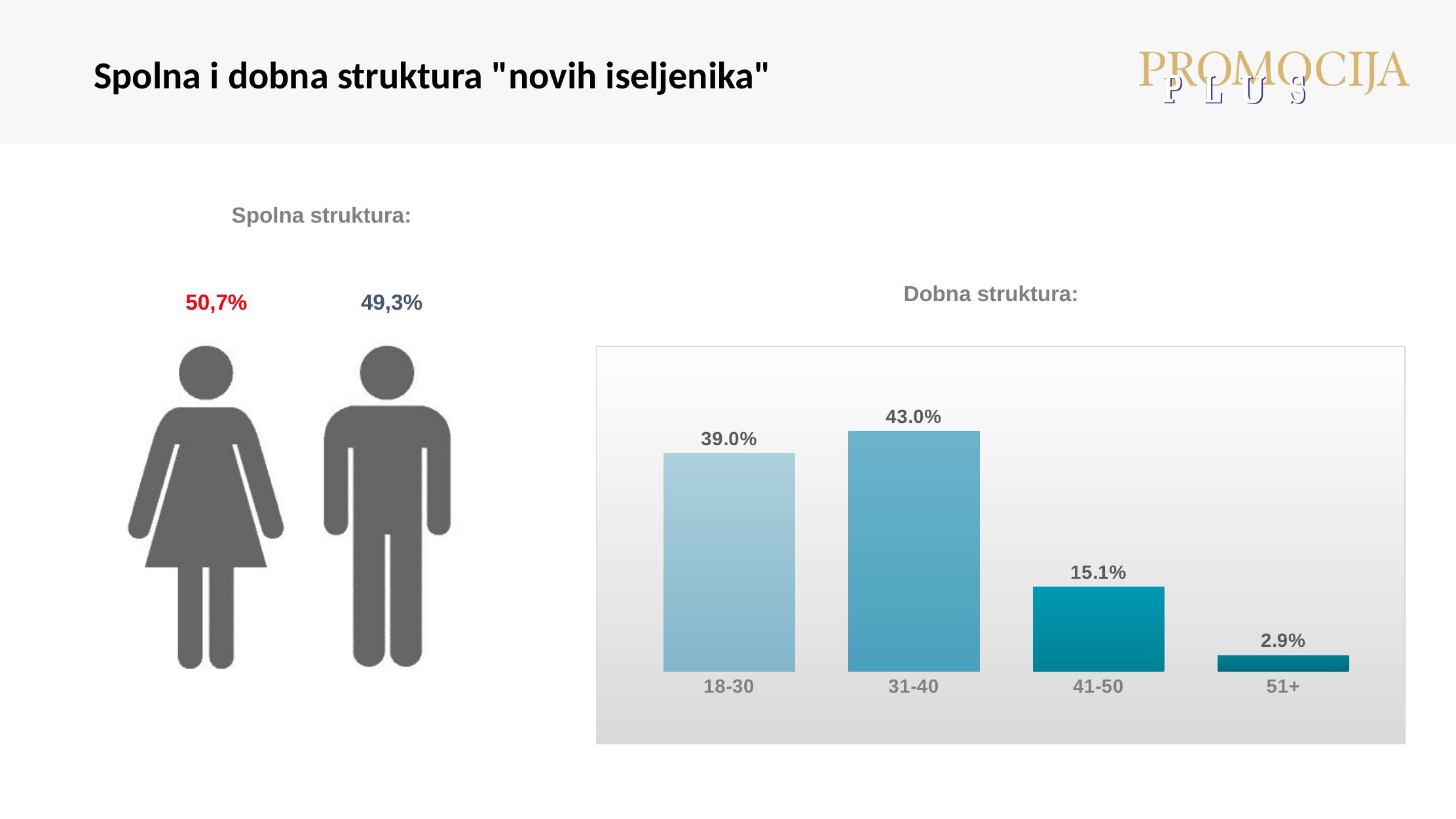
In the "Dobna struktura" chart, what is the value for the 18-30 age group? 39.0% In the "Dobna struktura" chart, which age group has the lowest value? 51+ In the "Spolna struktura" section on the left, what percentage is shown above the female figure? 50,7% In the "Dobna struktura" chart, what is the value for the 41-50 age group? 15.1% In the "Dobna struktura" chart, what is the difference between the values for 31-40 and 18-30? 4.0% In the "Dobna struktura" chart, which age group has the highest value? 31-40 What kind of chart is the "Dobna struktura" chart? bar chart How many age groups are shown in the "Dobna struktura" chart? 4 In the "Dobna struktura" chart, which is larger, the value for 18-30 or the value for 41-50? 18-30 In the "Dobna struktura" chart, what is the difference between the values for 41-50 and 51+? 12.2% In the "Dobna struktura" chart, what is the value for the 51+ age group? 2.9% In the "Dobna struktura" chart, what is the value for the 31-40 age group? 43.0%